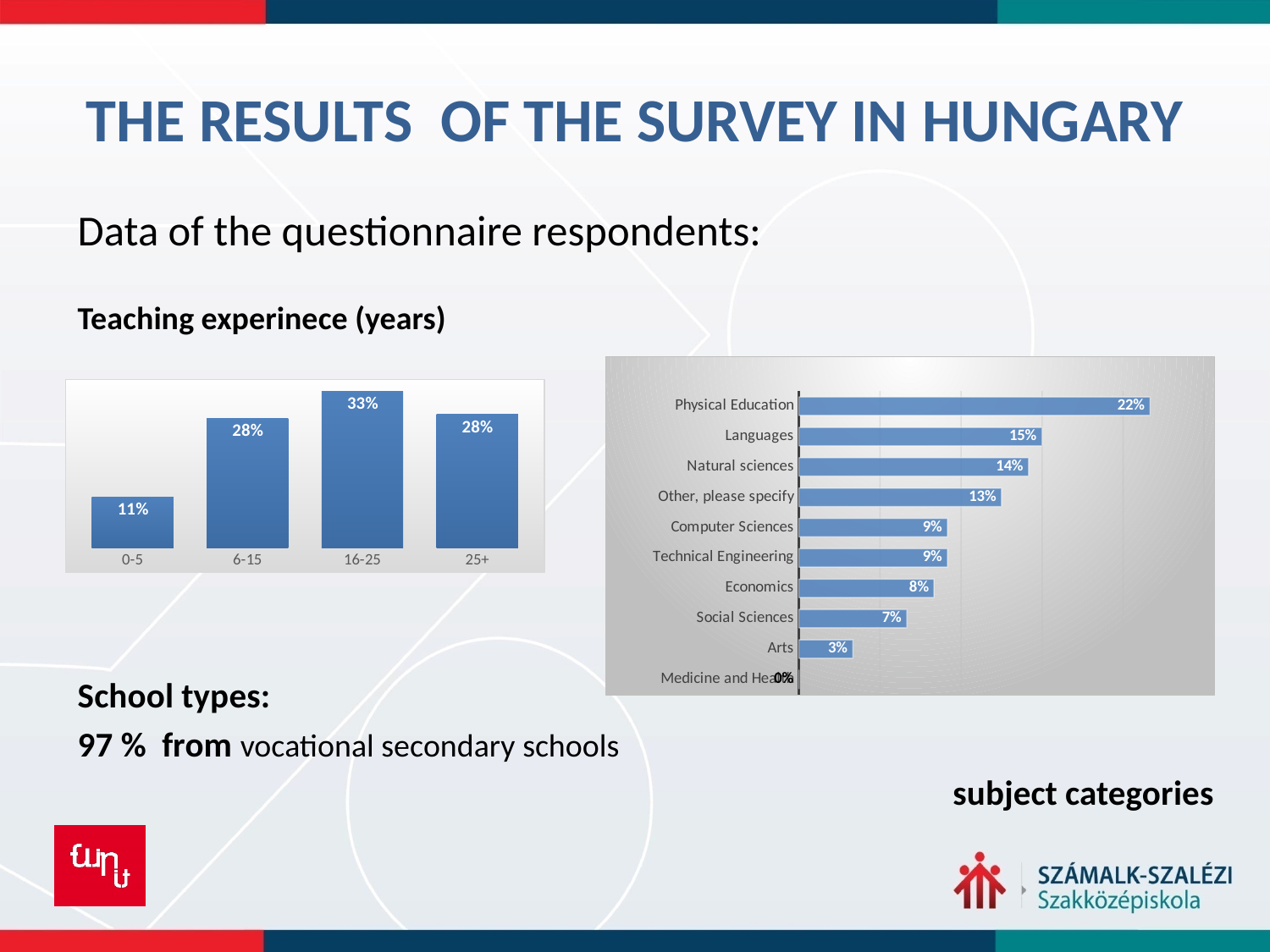
In the teaching experience chart, what percentage of respondents have 0-5 years of experience? 11% In the subject categories chart, what percentage is shown for Physical Education? 22% In the teaching experience chart, what percentage of respondents have 16-25 years of experience? 33% In the subject categories chart, which is larger, Languages or Natural sciences? Languages In the teaching experience chart, what is the difference between the 16-25 group and the 0-5 group? 22% In the subject categories chart, what is the difference between Physical Education and Arts? 19% How many experience groups are shown in the teaching experience chart? 4 What kind of chart is the subject categories chart? Bar chart In the teaching experience chart, which experience group has the lowest share of respondents? 0-5 In the subject categories chart, which subject has the highest percentage? Physical Education In the teaching experience chart, which experience group has the highest share of respondents? 16-25 In the subject categories chart, what percentage is shown for Social Sciences? 7%